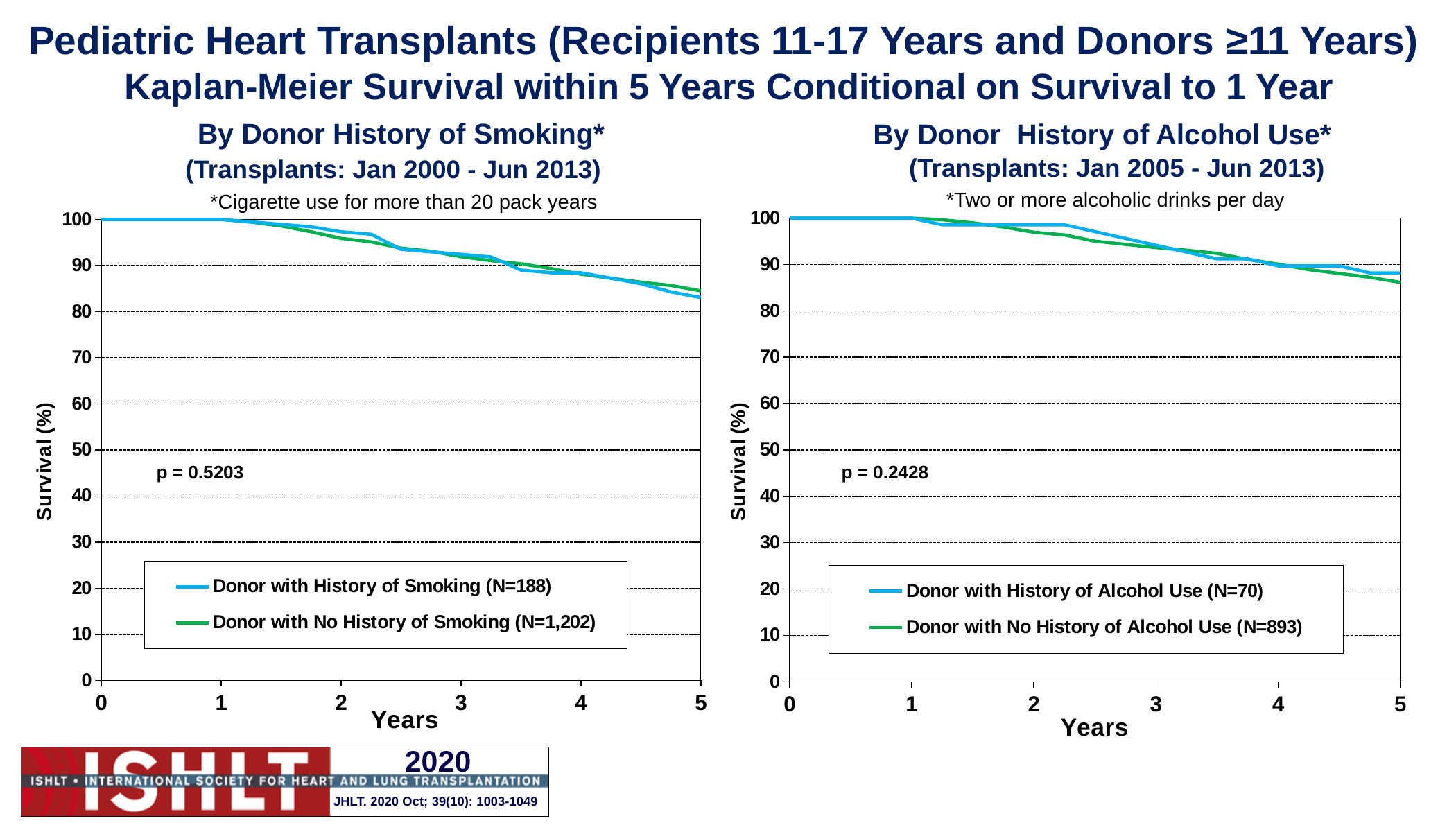
In the left chart, 'By Donor History of Smoking', what is the N for the 'Donor with History of Smoking' series? N=188 In the right chart, 'By Donor History of Alcohol Use', what is the p-value shown? p = 0.2428 In the left chart, 'By Donor History of Smoking', what is the N for the 'Donor with No History of Smoking' series? N=1,202 In the right chart, 'By Donor History of Alcohol Use', what is the N for the 'Donor with No History of Alcohol Use' series? N=893 In the right chart, 'By Donor History of Alcohol Use', is the survival value for 'Donor with No History of Alcohol Use' at 5 years greater or less than 80? greater In the right chart, 'By Donor History of Alcohol Use', do the survival curves rise or fall as years increase from 1 to 5? Fall In the left chart, 'By Donor History of Smoking', is the survival value for 'Donor with History of Smoking' at 5 years greater or less than 90? less In the right chart, 'By Donor History of Alcohol Use', what is the N for the 'Donor with History of Alcohol Use' series? N=70 What type of chart is the left chart, 'By Donor History of Smoking'? Line chart How many series does the legend of the left chart, 'By Donor History of Smoking', list? 2 In the left chart, 'By Donor History of Smoking', what is the p-value shown? p = 0.5203 How many series does the legend of the right chart, 'By Donor History of Alcohol Use', list? 2